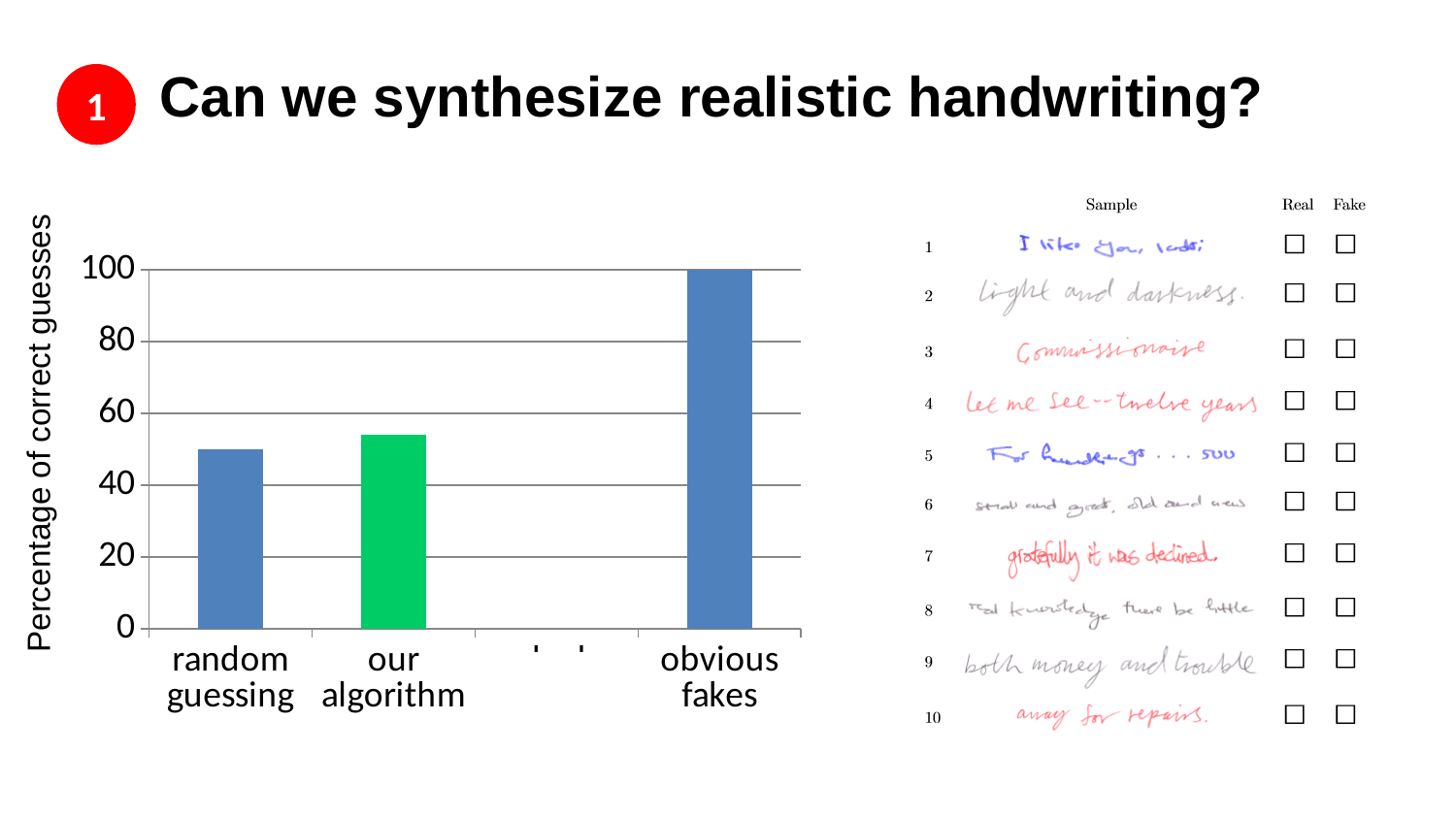
What kind of chart is shown on the slide? bar chart Which is larger, the value for obvious fakes or the value for our algorithm? obvious fakes Which is larger, the value for obvious fakes or the value for random guessing? obvious fakes Which category has the highest percentage of correct guesses? obvious fakes How many bars are plotted in the chart? 3 What is the label of the vertical axis? Percentage of correct guesses Is the value for our algorithm greater or less than 80? less Is the value for our algorithm greater or less than 40? greater Is the value for random guessing greater or less than 40? greater What is the percentage of correct guesses for obvious fakes? 100 What colour is the bar for our algorithm? green